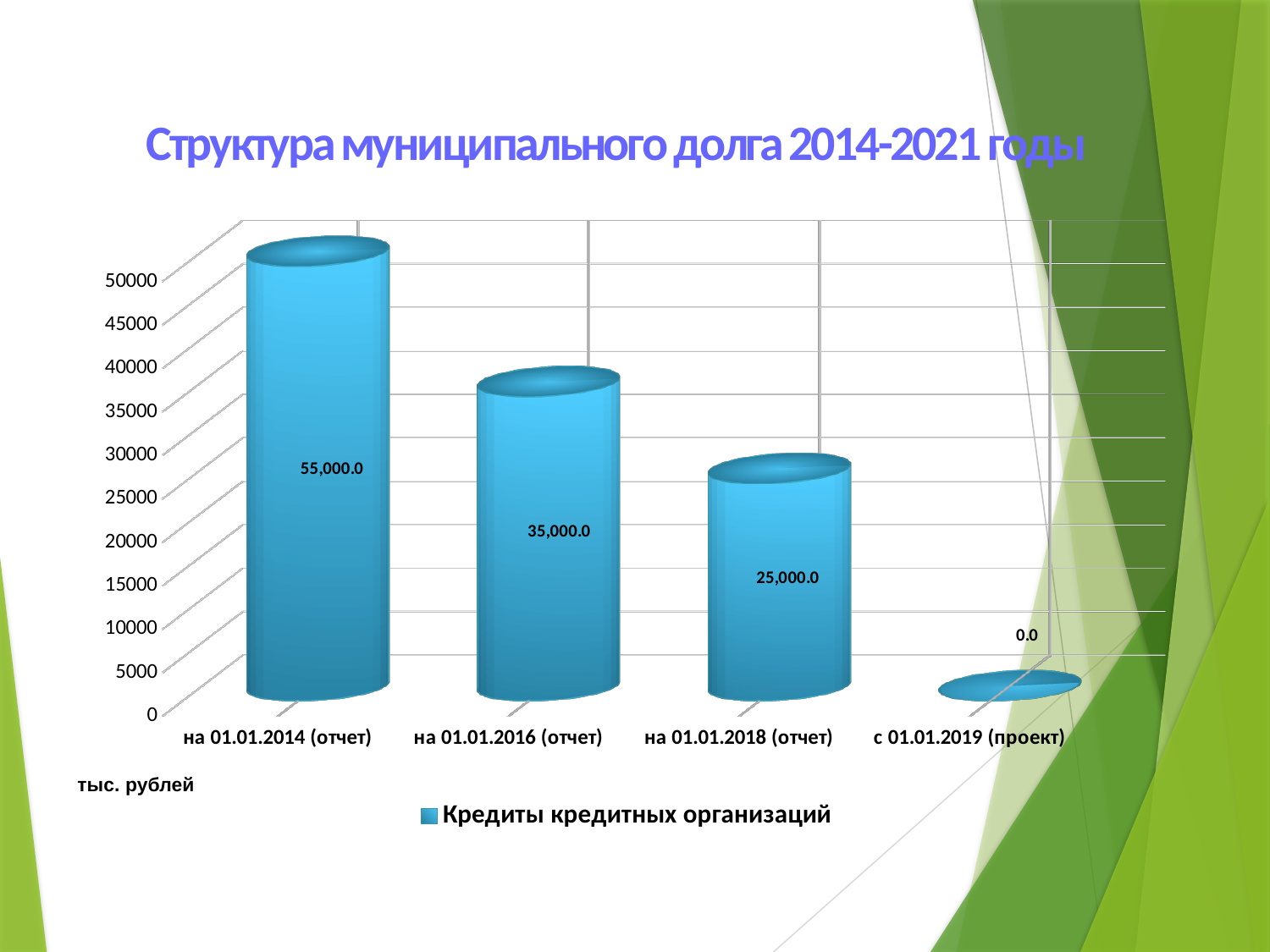
What is the value for "на 01.01.2016 (отчет)"? 35,000.0 Which category has the highest value? на 01.01.2014 (отчет) What is the difference between the values for "на 01.01.2014 (отчет)" and "на 01.01.2016 (отчет)"? 20,000.0 How many series does the legend list? 1 What kind of chart is shown? bar chart What is the value for "на 01.01.2014 (отчет)"? 55,000.0 Which category has the lowest value? с 01.01.2019 (проект) Which is larger, the value for "на 01.01.2016 (отчет)" or "на 01.01.2018 (отчет)"? на 01.01.2016 (отчет) How many categories are shown on the x axis? 4 Do the values rise or fall along the x axis? fall What is the value for "на 01.01.2018 (отчет)"? 25,000.0 What is the value for "с 01.01.2019 (проект)"? 0.0